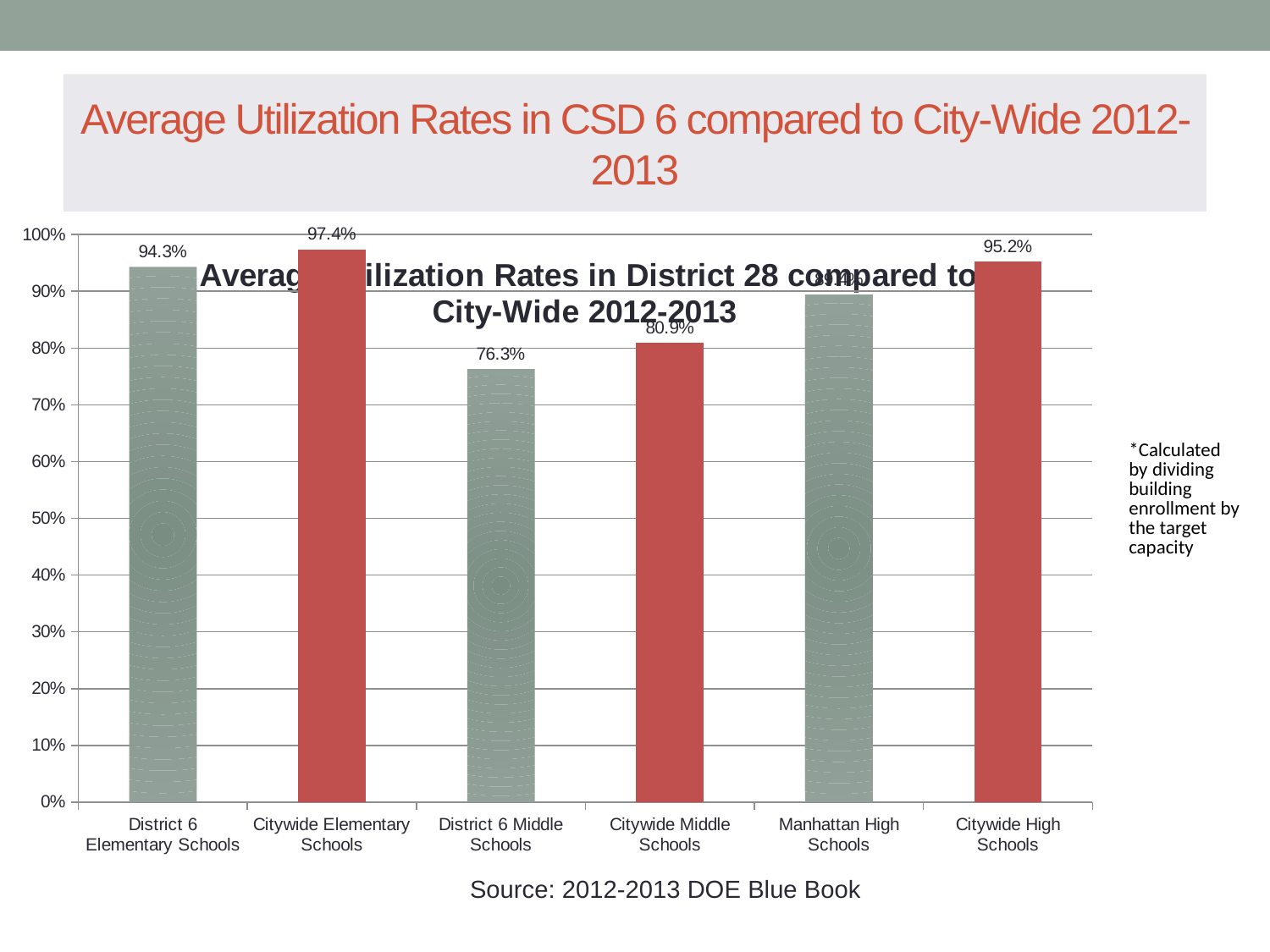
What kind of chart is shown on the slide? bar chart What is the average utilization rate for District 6 Elementary Schools? 94.3% What is the average utilization rate for District 6 Middle Schools? 76.3% Which category has the lowest utilization rate? District 6 Middle Schools Is the utilization rate for Manhattan High Schools greater or less than 80%? greater Which category has the highest utilization rate? Citywide Elementary Schools What is the average utilization rate for Citywide High Schools? 95.2% How much higher is the utilization rate for Citywide Elementary Schools than for District 6 Elementary Schools? 3.1 percentage points Which has a higher utilization rate: District 6 Middle Schools or Citywide Middle Schools? Citywide Middle Schools What is the average utilization rate for Citywide Middle Schools? 80.9% How many categories are shown on the x axis of the chart? 6 What is the average utilization rate for Citywide Elementary Schools? 97.4%